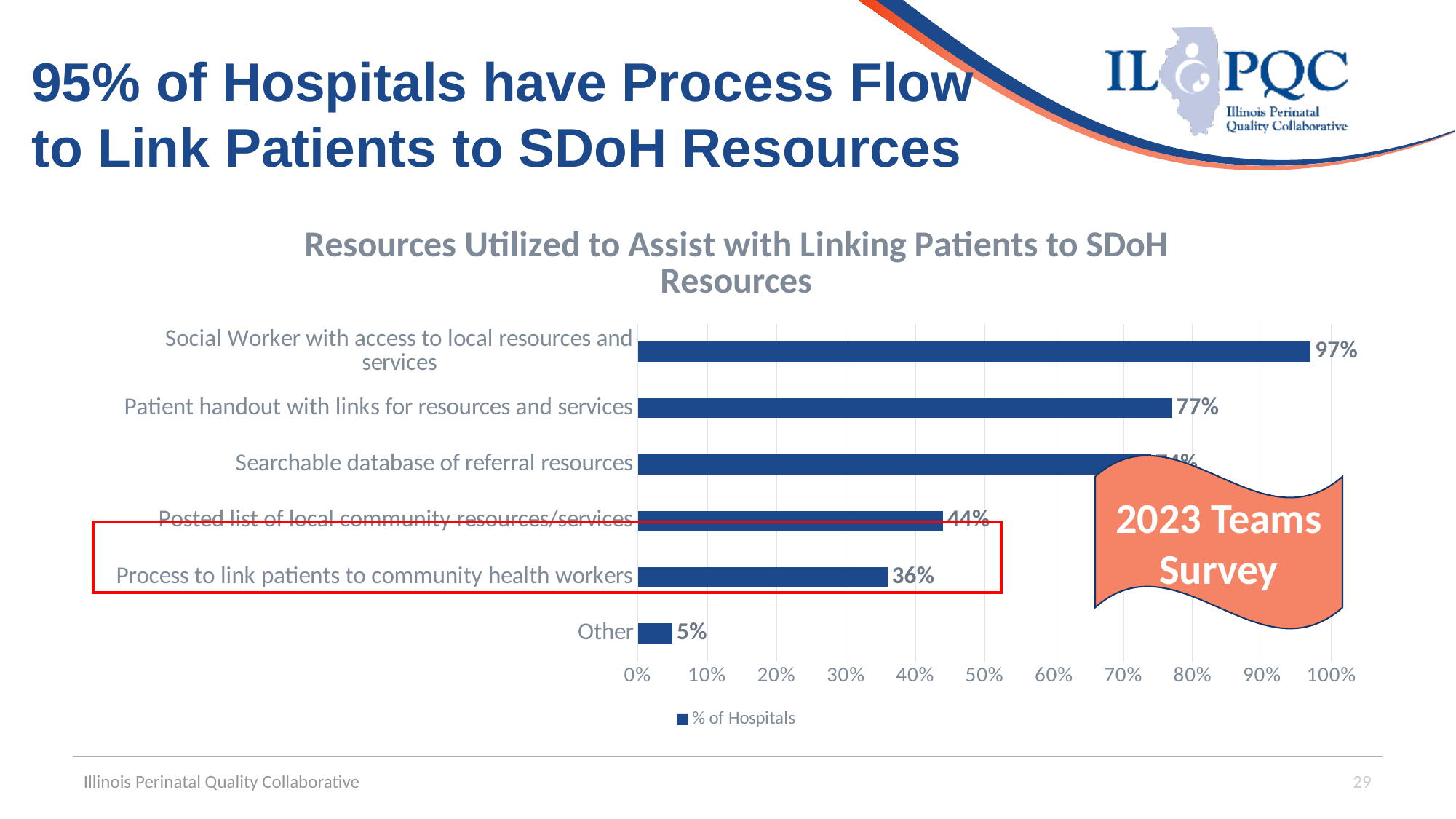
Which category has the lowest value? Other What is the value for 'Social Worker with access to local resources and services'? 97% Is the value for 'Searchable database of referral resources' greater or less than 70%? greater What is the value for 'Patient handout with links for resources and services'? 77% What is the difference between the values for 'Social Worker with access to local resources and services' and 'Patient handout with links for resources and services'? 20% Which is larger: the value for 'Posted list of local community resources/services' or 'Process to link patients to community health workers'? Posted list of local community resources/services What is the value for 'Other'? 5% What is the value for 'Posted list of local community resources/services'? 44% What is the value for 'Process to link patients to community health workers'? 36% How many categories are shown in the chart? 6 Which category has the highest value? Social Worker with access to local resources and services What type of chart is shown on the slide? bar chart